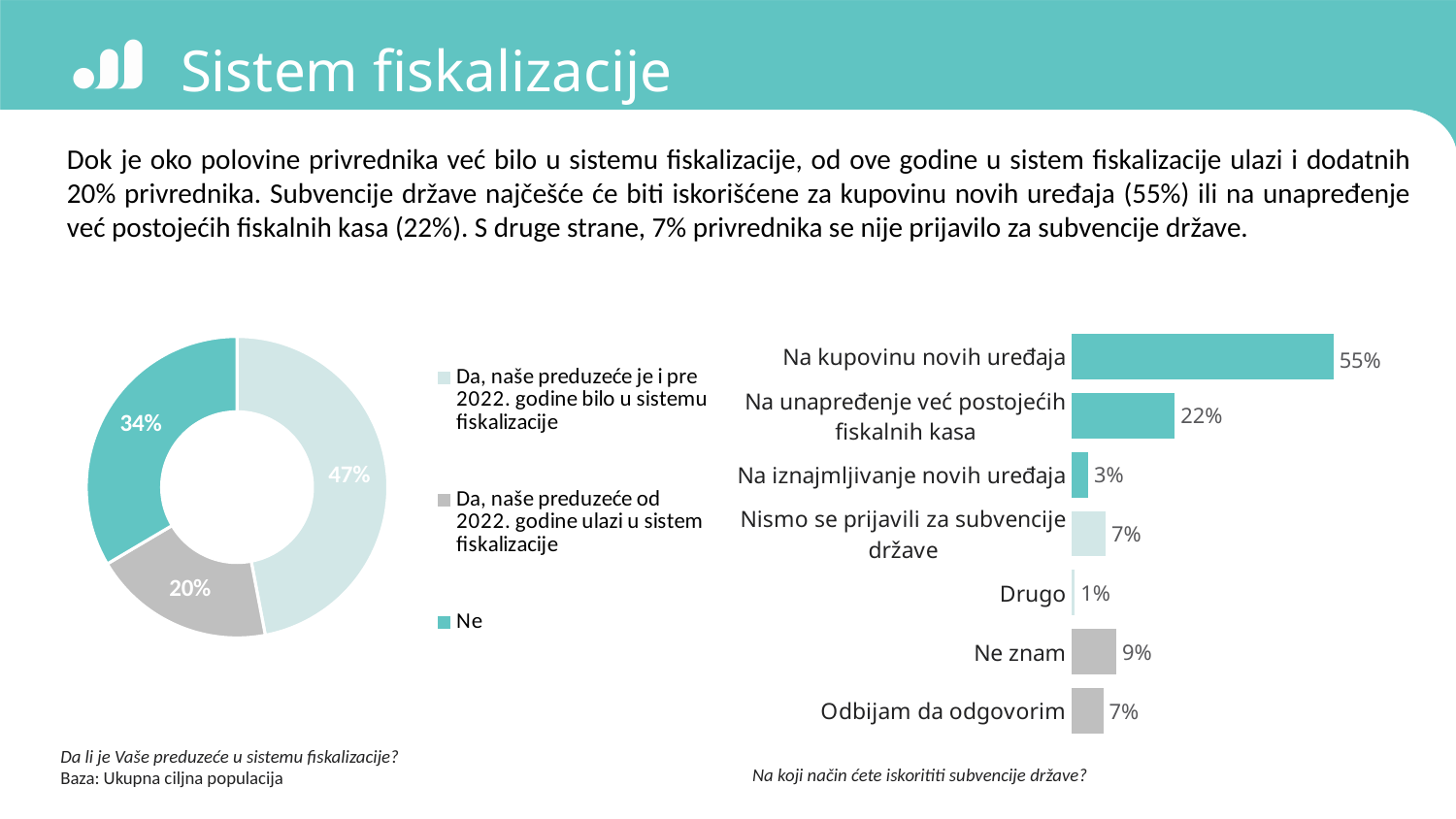
In the bar chart on the right, which category has the lowest value? Drugo In the bar chart on the right, what is the value for "Ne znam"? 9% In the bar chart on the right, what is the value for "Na kupovinu novih uređaja"? 55% In the donut chart on the left, which category has the largest share? Da, naše preduzeće je i pre 2022. godine bilo u sistemu fiskalizacije How many categories does the bar chart on the right show? 7 In the donut chart on the left, what is the value for "Da, naše preduzeće od 2022. godine ulazi u sistem fiskalizacije"? 20% How many entries does the legend of the donut chart on the left list? 3 In the bar chart on the right, which category has the highest value? Na kupovinu novih uređaja What kind of chart is on the right side of the slide? Bar chart In the bar chart on the right, what is the difference between "Na kupovinu novih uređaja" and "Na unapređenje već postojećih fiskalnih kasa"? 33% In the donut chart on the left, what is the share for "Ne"? 34% In the bar chart on the right, which is larger: "Ne znam" or "Na iznajmljivanje novih uređaja"? Ne znam